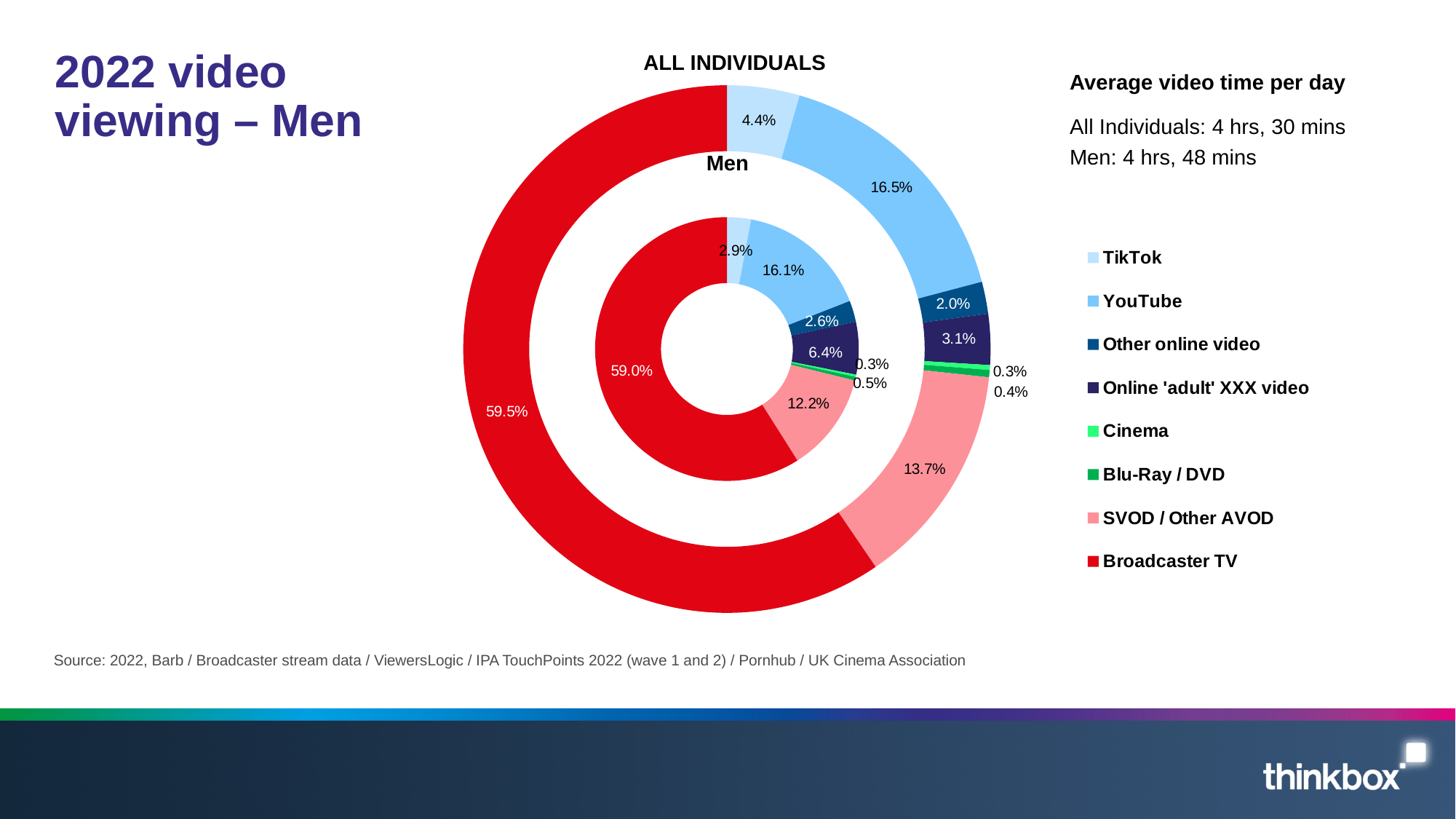
How many categories does the legend list? 8 Which category has the largest share in the Men ring? Broadcaster TV Which category has the smallest share in the All Individuals ring? Cinema In the outer ring (All Individuals), what share is Broadcaster TV? 59.5% Which is larger: the Online 'adult' XXX video share for Men or for All Individuals? Men What is the difference between the TikTok share for All Individuals (4.4%) and for Men (2.9%)? 1.5% In the inner ring (Men), what share is YouTube? 16.1% In the inner ring (Men), what share is Broadcaster TV? 59.0% In the inner ring (Men), what share is Online 'adult' XXX video? 6.4% According to the text on the slide, what is the average video time per day for Men? 4 hrs, 48 mins What kind of chart is shown on the slide? Doughnut chart In the outer ring (All Individuals), what share is SVOD / Other AVOD? 13.7%